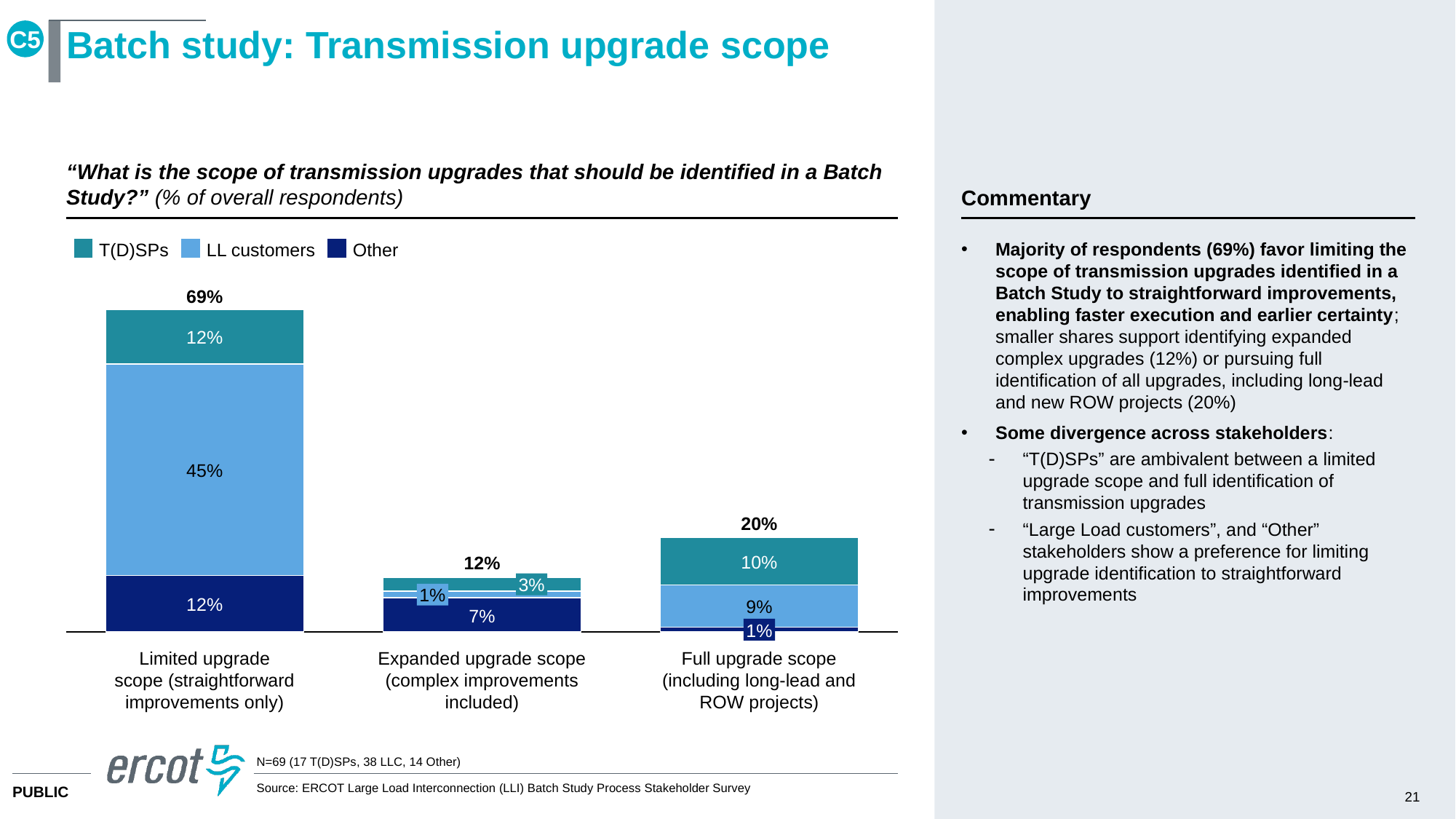
Which category has the lowest total value? Expanded upgrade scope (complex improvements included) What is the LL customers value for 'Limited upgrade scope (straightforward improvements only)'? 45% What is the T(D)SPs value for 'Full upgrade scope (including long-lead and ROW projects)'? 10% What is the Other value for 'Expanded upgrade scope (complex improvements included)'? 7% Which category has the highest total value? Limited upgrade scope (straightforward improvements only) How many categories are shown on the x axis? 3 How many series does the legend list? 3 What is the difference between the total for 'Limited upgrade scope' and the total for 'Full upgrade scope'? 49% Which is larger: the LL customers value for 'Full upgrade scope' or the LL customers value for 'Expanded upgrade scope'? Full upgrade scope What type of chart is shown on the slide? Stacked bar chart What is the total value labelled above the 'Limited upgrade scope (straightforward improvements only)' bar? 69% Which legend entry is shown in the darkest blue colour? Other